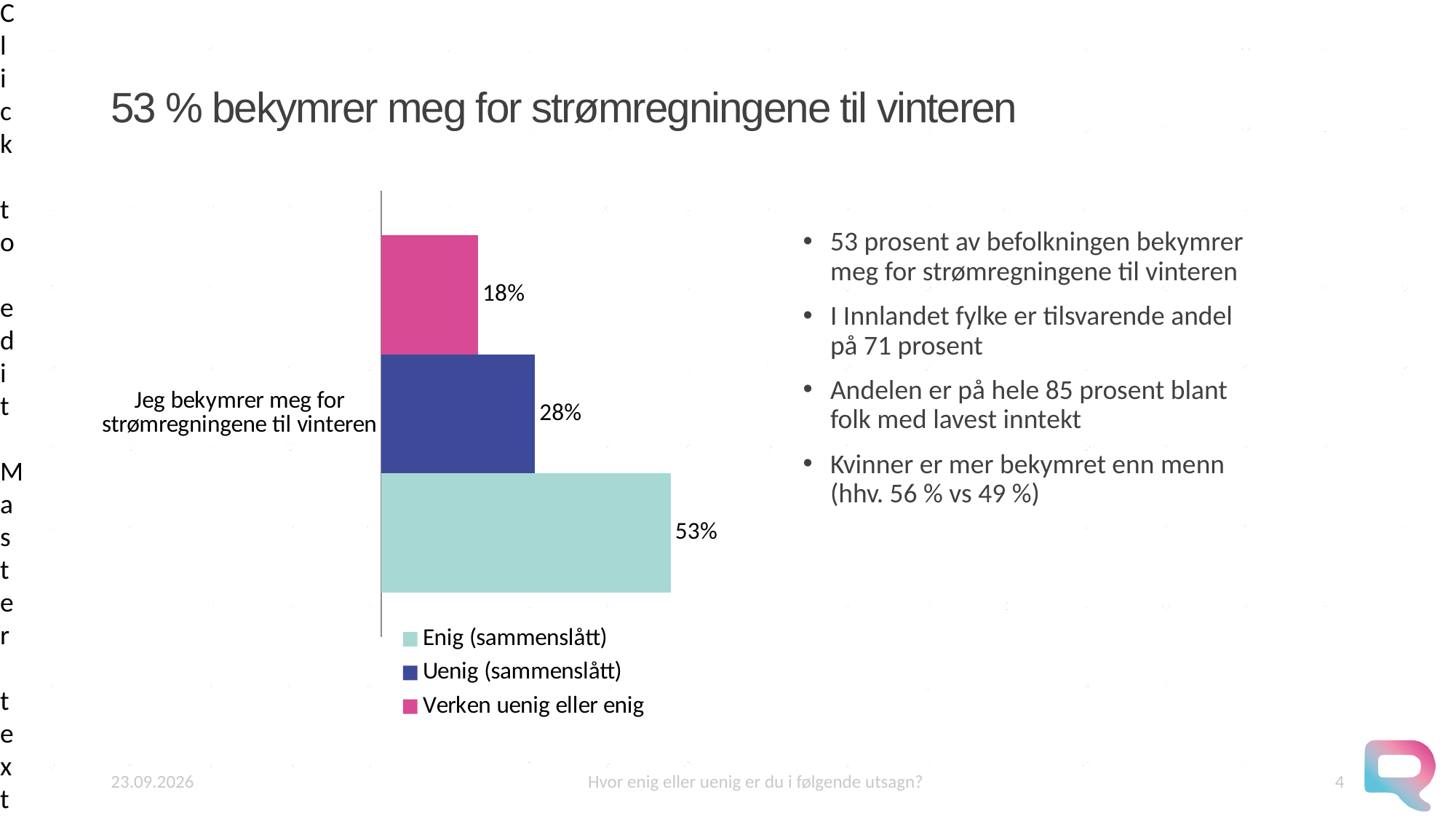
What is the value for Uenig (sammenslått) in the chart? 28% What is the difference between the values for Uenig (sammenslått) and Verken uenig eller enig? 10% Which series has the highest value in the chart? Enig (sammenslått) How many series does the legend list? 3 What kind of chart is shown on the slide? Bar chart What is the value for Enig (sammenslått) in the chart? 53% Which is larger, the value for Uenig (sammenslått) or the value for Verken uenig eller enig? Uenig (sammenslått) Which series has the lowest value in the chart? Verken uenig eller enig What is the difference between the values for Enig (sammenslått) and Uenig (sammenslått)? 25% What is the category label shown on the chart's axis? Jeg bekymrer meg for strømregningene til vinteren What is the value for Verken uenig eller enig in the chart? 18% How many categories are shown on the chart's category axis? 1